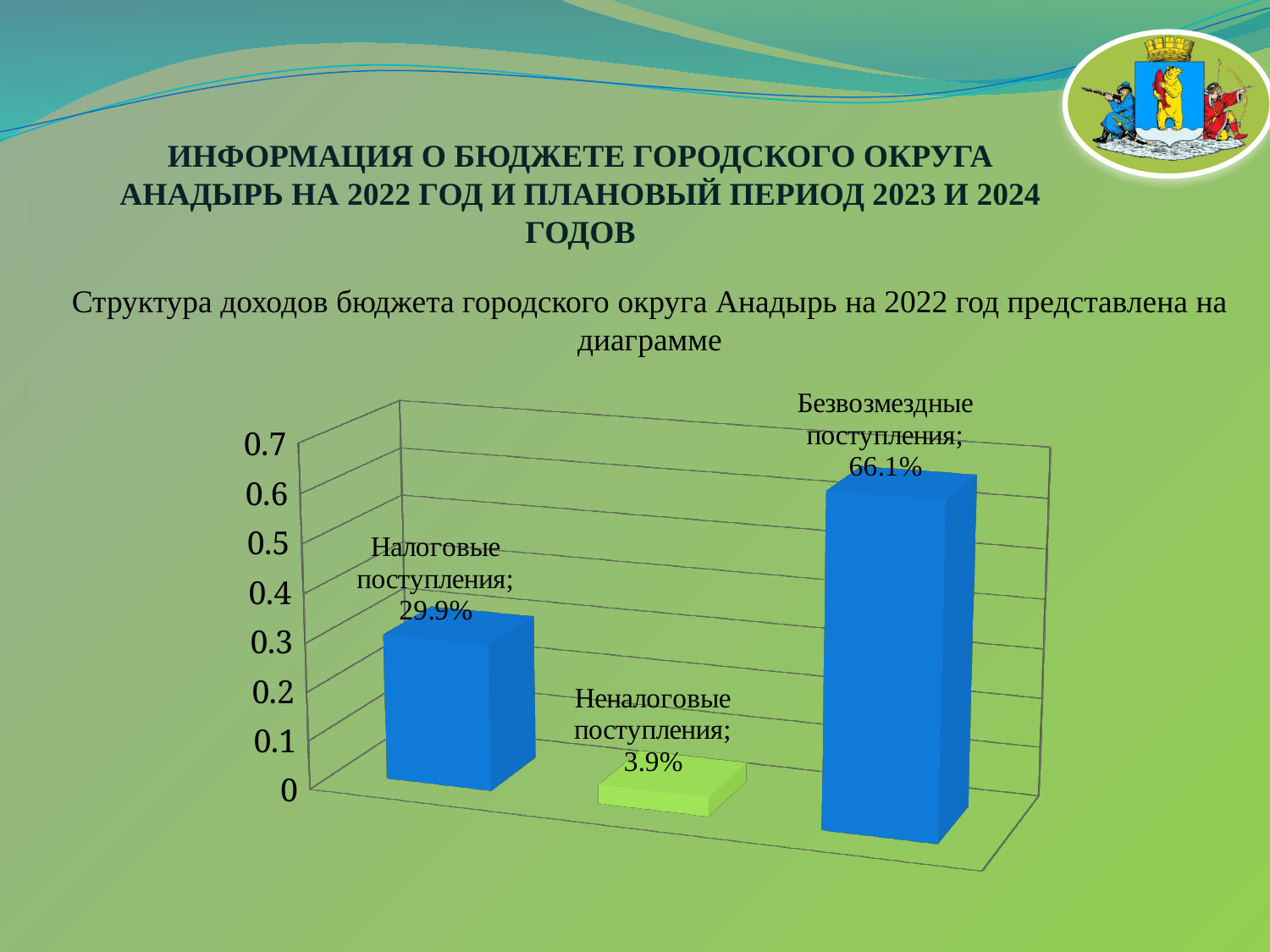
What is the difference between the values for Налоговые поступления and Неналоговые поступления? 26.0% What is the value for Неналоговые поступления? 3.9% What is the difference between the values for Безвозмездные поступления and Налоговые поступления? 36.2% What is the value for Налоговые поступления? 29.9% Is the value for Безвозмездные поступления greater or less than 0.5 on the axis? greater How many categories are shown in the chart? 3 Which is larger, the value for Налоговые поступления or the value for Неналоговые поступления? Налоговые поступления Which category has the lowest value? Неналоговые поступления Which category has the highest value? Безвозмездные поступления What kind of chart is shown on the slide? Bar chart What is the highest value shown on the vertical axis? 0.7 What is the value for Безвозмездные поступления? 66.1%